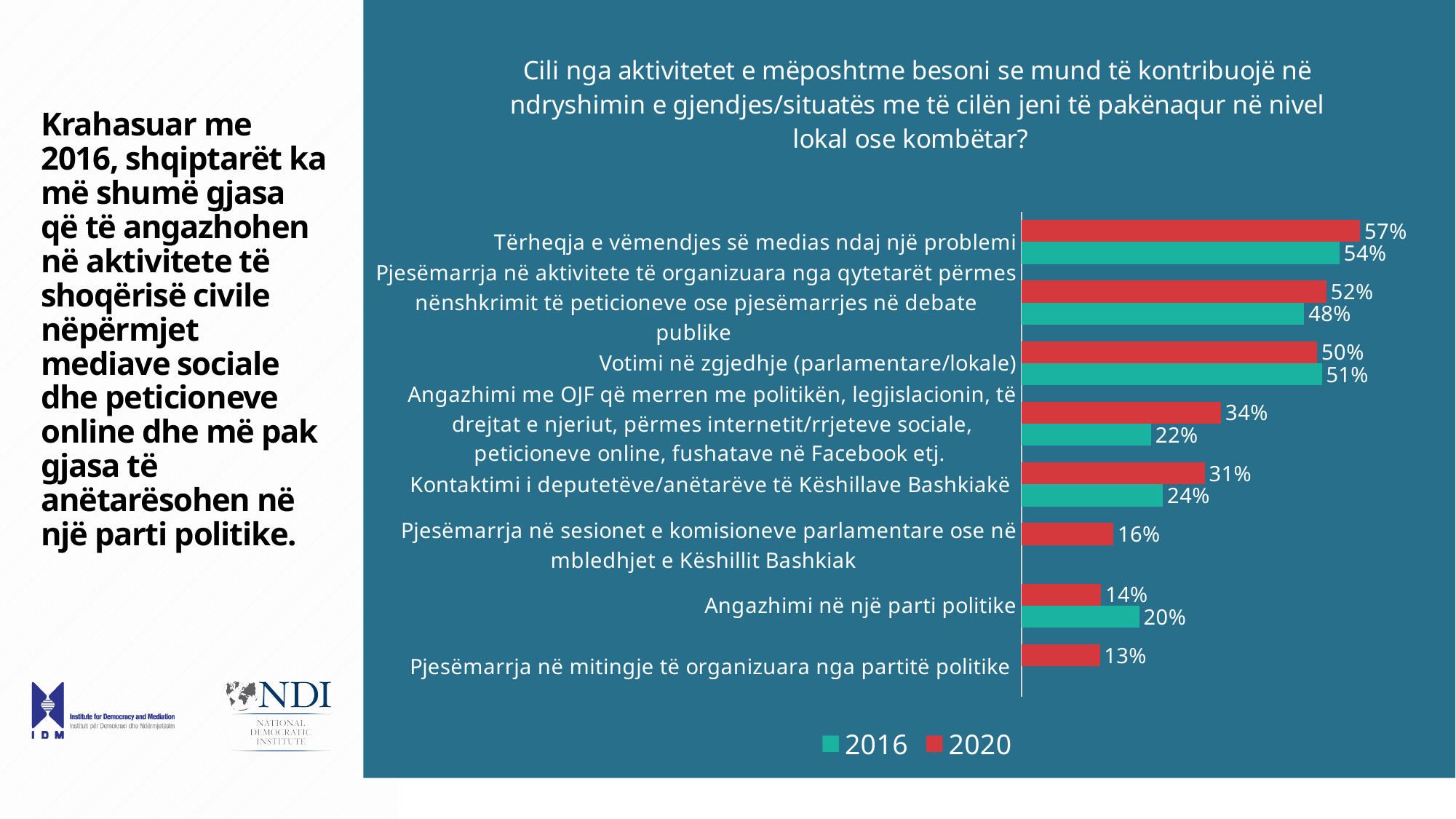
What kind of chart is shown on the slide? Bar chart What is the 2020 value for "Pjesëmarrja në mitingje të organizuara nga partitë politike"? 13% How many series does the legend list? 2 What is the 2016 value for "Angazhimi në një parti politike"? 20% For "Angazhimi në një parti politike", which year has the larger value, 2016 or 2020? 2016 Which category has the lowest 2020 value? Pjesëmarrja në mitingje të organizuara nga partitë politike Which category has the highest 2020 value? Tërheqja e vëmendjes së medias ndaj një problemi How many categories are shown on the chart? 8 What is the 2020 value for "Tërheqja e vëmendjes së medias ndaj një problemi"? 57% What is the 2016 value for "Votimi në zgjedhje (parlamentare/lokale)"? 51% For "Kontaktimi i deputetëve/anëtarëve të Këshillave Bashkiakë", which year has the larger value, 2016 or 2020? 2020 What is the difference between the 2020 and 2016 values for "Angazhimi me OJF që merren me politikën, legjislacionin, të drejtat e njeriut..."? 12%